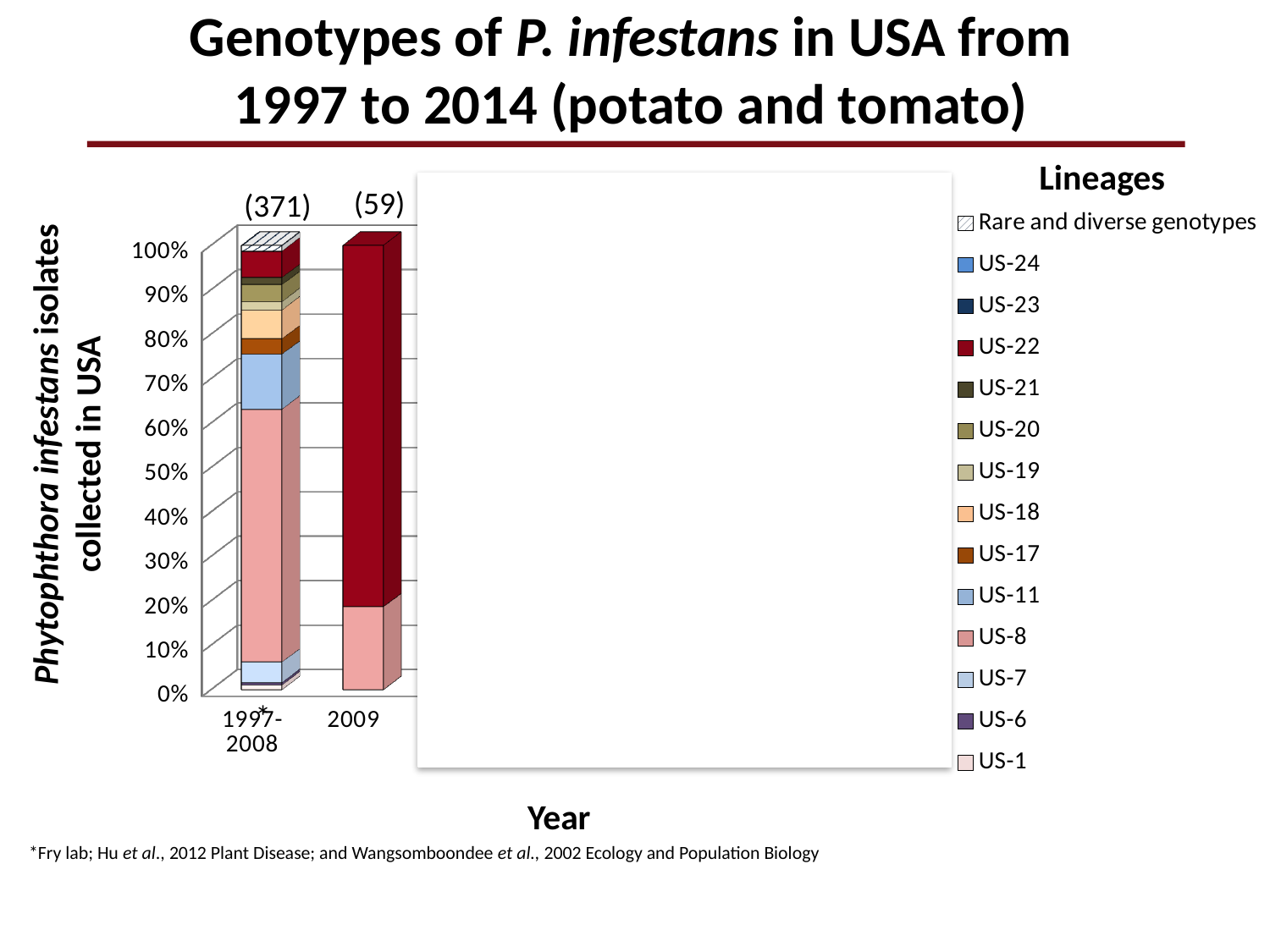
Which lineage makes up the largest share of the 2009 bar? US-22 Is the share of US-8 in the 2009 bar greater or less than 30%? less How many lineages does the legend list? 14 What number of isolates is printed above the 2009 bar? (59) How many year categories are visible on the x axis of the chart? 2 Is the share of US-22 larger in the 2009 bar or in the 1997-2008 bar? 2009 Which lineage makes up the largest share of the 1997-2008 bar? US-8 What kind of chart is shown on the slide? stacked bar chart What is the x-axis title of the chart? Year What is the title of the legend? Lineages What number of isolates is printed above the 1997-2008 bar? (371) Is the share of US-22 in the 2009 bar greater or less than 50%? greater